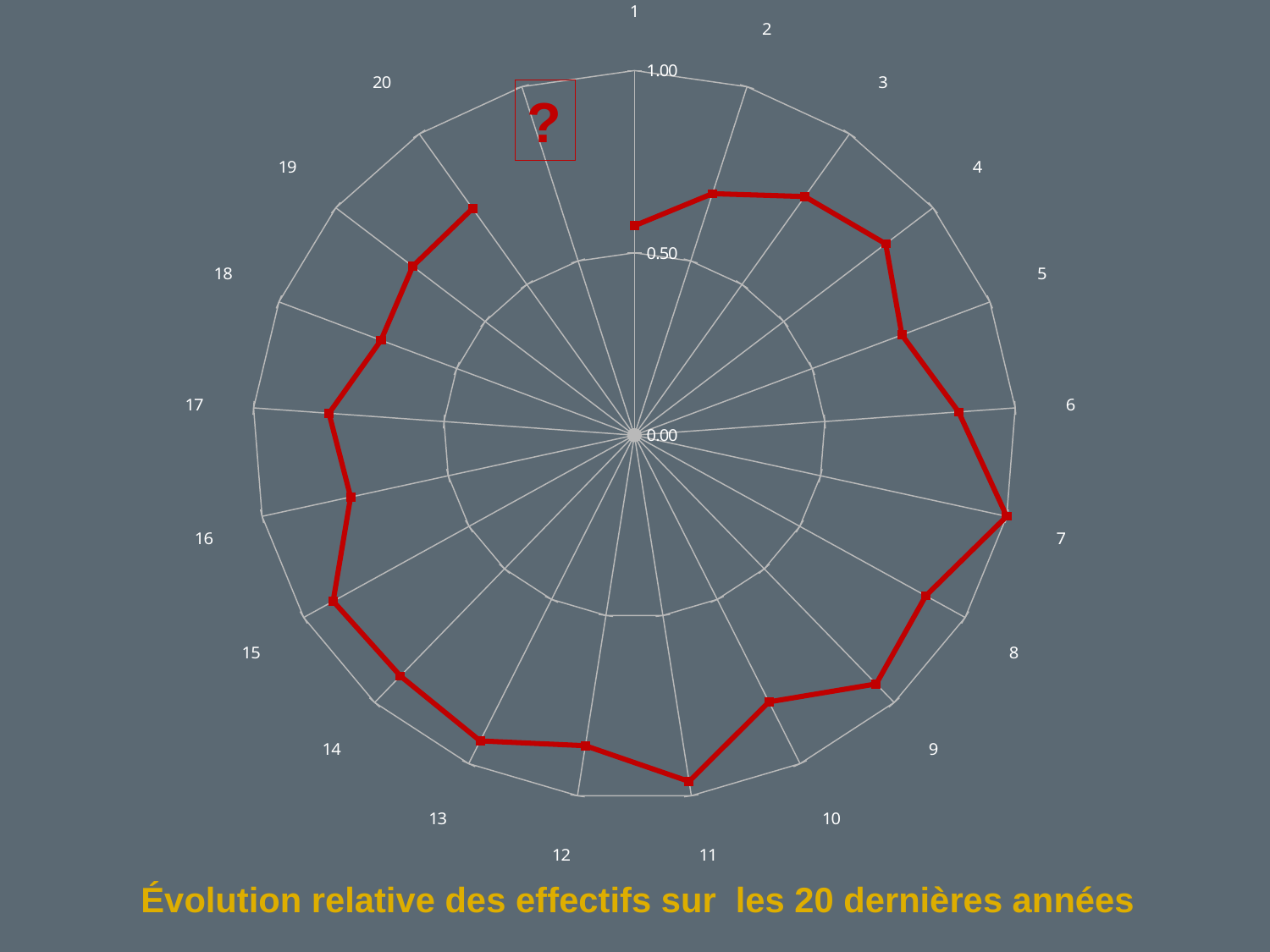
Which has the larger value, category 7 or category 1? 7 Which has the larger value, category 11 or category 12? 11 How many categories are labelled around the chart? 20 What kind of chart is shown on the slide? radar chart Which plotted category has the lowest value on the chart? 1 Is the value for category 7 greater or less than 0.50? greater What is the title of the chart? Évolution relative des effectifs sur les 20 dernières années Is the value for category 11 greater or less than 0.50? greater Which category has no plotted point and is marked with a question mark? 20 Is the value for category 1 greater or less than 1.00? less Which category has the highest value on the chart? 7 Do the values rise or fall from category 1 to category 7? rise